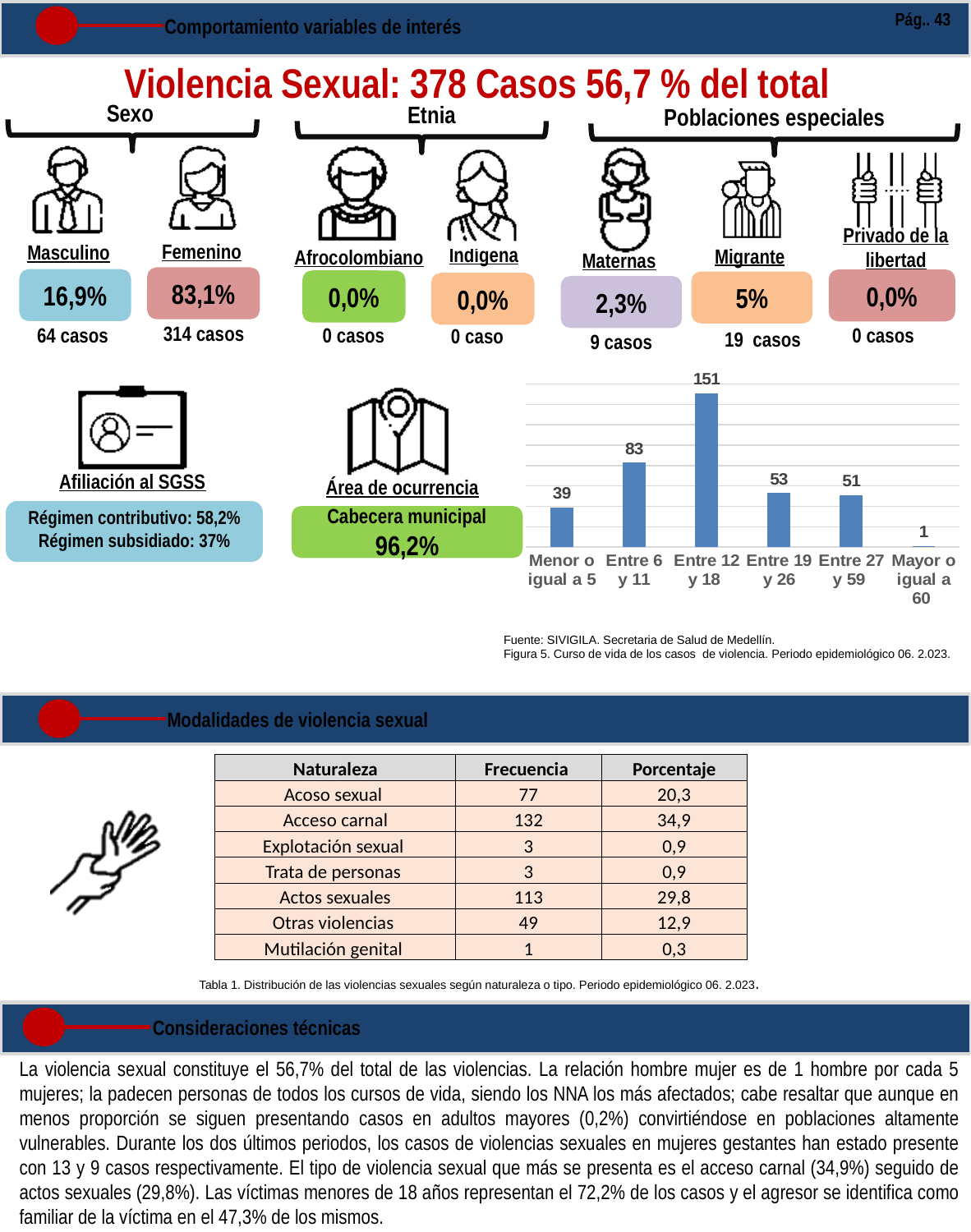
In the bar chart, what is the value for 'Mayor o igual a 60'? 1 In the bar chart, do the values rise or fall from 'Entre 12 y 18' to 'Mayor o igual a 60'? fall In the bar chart, what is the value for 'Menor o igual a 5'? 39 Which age group has the highest number of cases in the bar chart? Entre 12 y 18 In the bar chart, what is the value for 'Entre 27 y 59'? 51 Which age group has the lowest number of cases in the bar chart? Mayor o igual a 60 What type of chart is used to show the cases by age group (curso de vida)? bar chart In the bar chart, what is the difference between the 'Entre 12 y 18' and 'Entre 6 y 11' values? 68 According to the caption, what figure number is the bar chart of cases by age group? Figura 5 How many age-group categories are shown in the bar chart? 6 In the bar chart, how many cases are in the 'Entre 12 y 18' age group? 151 In the bar chart, which is larger: 'Entre 6 y 11' or 'Entre 19 y 26'? Entre 6 y 11